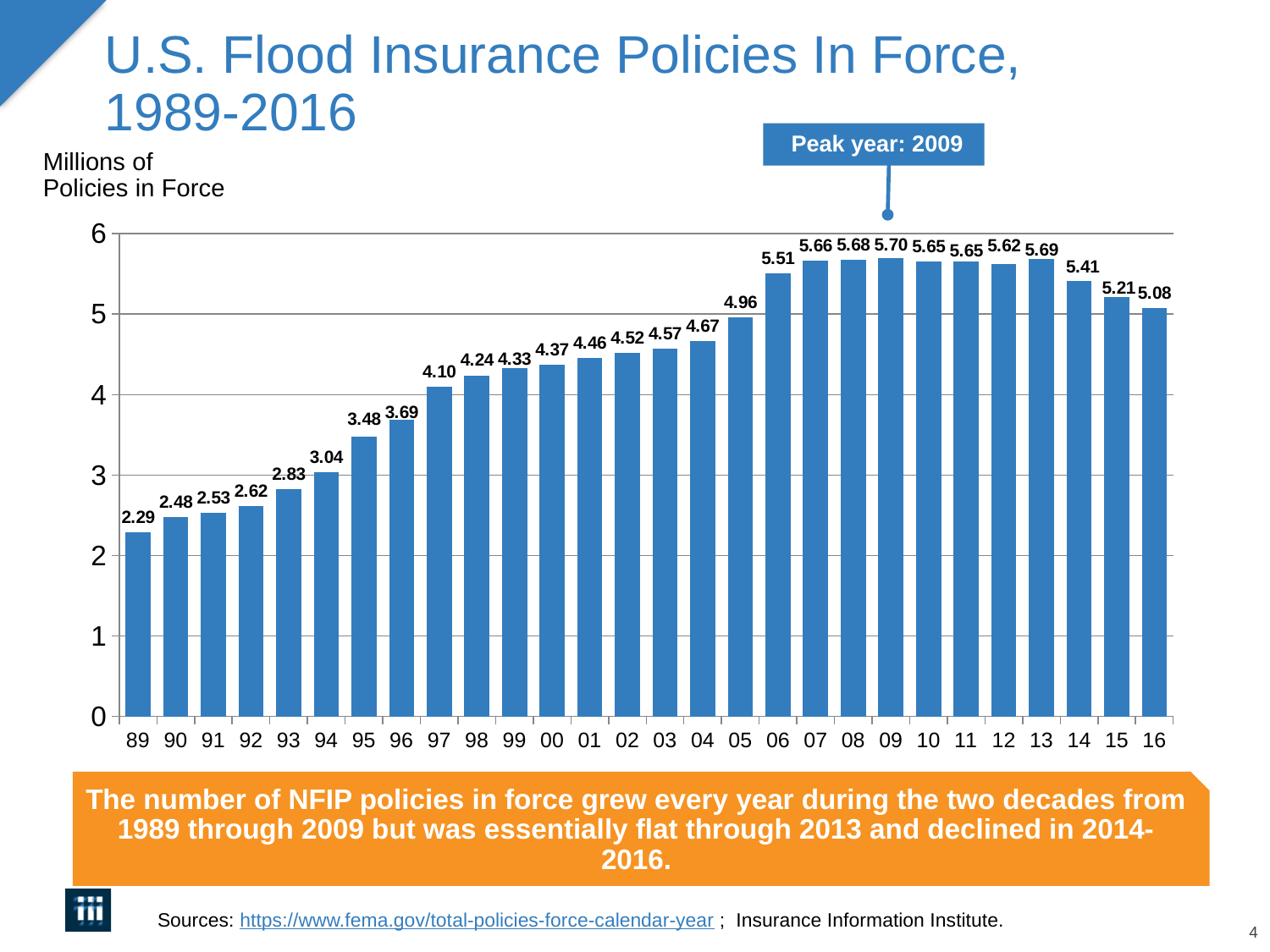
What kind of chart is this? bar chart What is the title of the chart? U.S. Flood Insurance Policies In Force, 1989-2016 What is the value for 2016 (16)? 5.08 What is the value for 1989 (89)? 2.29 Which is larger, the value for 2005 (05) or the value for 2014 (14)? 14 Do the values rise or fall from 1989 to 2009? rise How many years are shown on the x axis? 28 Is the value for 1997 (97) greater or less than 4? greater Which year has the highest value? 09 Which year has the lowest value? 89 What is the value for 2009 (09)? 5.70 What is the difference between the values for 2009 (09) and 2016 (16)? 0.62